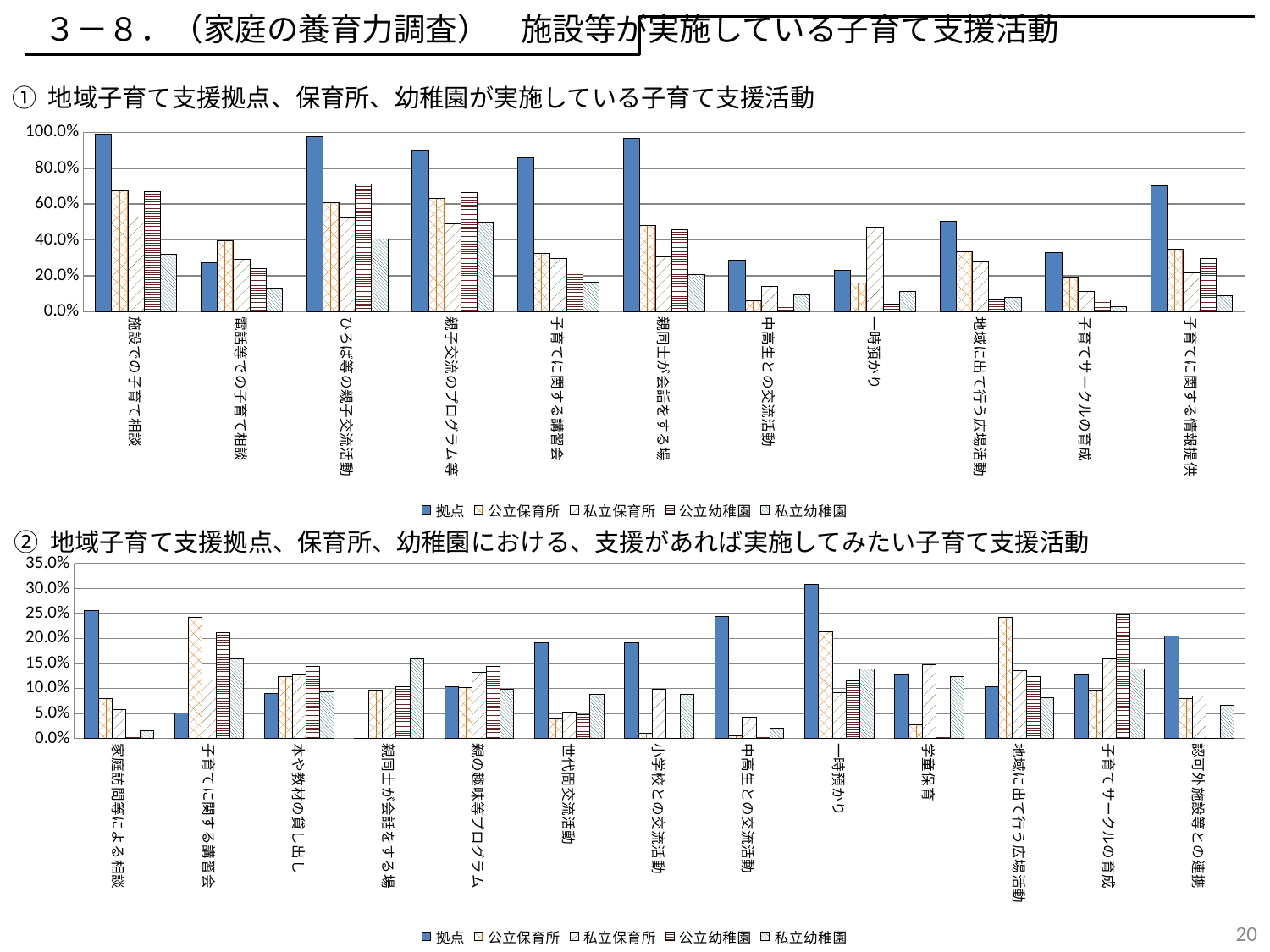
What are the legend entries of the bottom chart (②)? 拠点, 公立保育所, 私立保育所, 公立幼稚園, 私立幼稚園 In the bottom chart (②), is the value of 公立幼稚園 for 子育てサークルの育成 greater or less than 20.0%? greater How many series does the legend of the top chart (①) list? 5 In the top chart (①), for 電話等での子育て相談, which is larger: 拠点 or 公立保育所? 公立保育所 How many categories are shown on the x axis of the bottom chart (②)? 13 In the top chart (①), is the value of 拠点 for 中高生との交流活動 greater or less than 40.0%? less How many categories are shown on the x axis of the top chart (①)? 11 What kind of chart is the top chart (①)? bar chart In the bottom chart (②), which category has the highest value for the 拠点 series? 一時預かり In the top chart (①), which series has the highest value for 一時預かり? 私立保育所 In the top chart (①), is the value of 拠点 for 施設での子育て相談 greater or less than 80.0%? greater In the bottom chart (②), for 子育てに関する講習会, which is larger: 拠点 or 公立保育所? 公立保育所